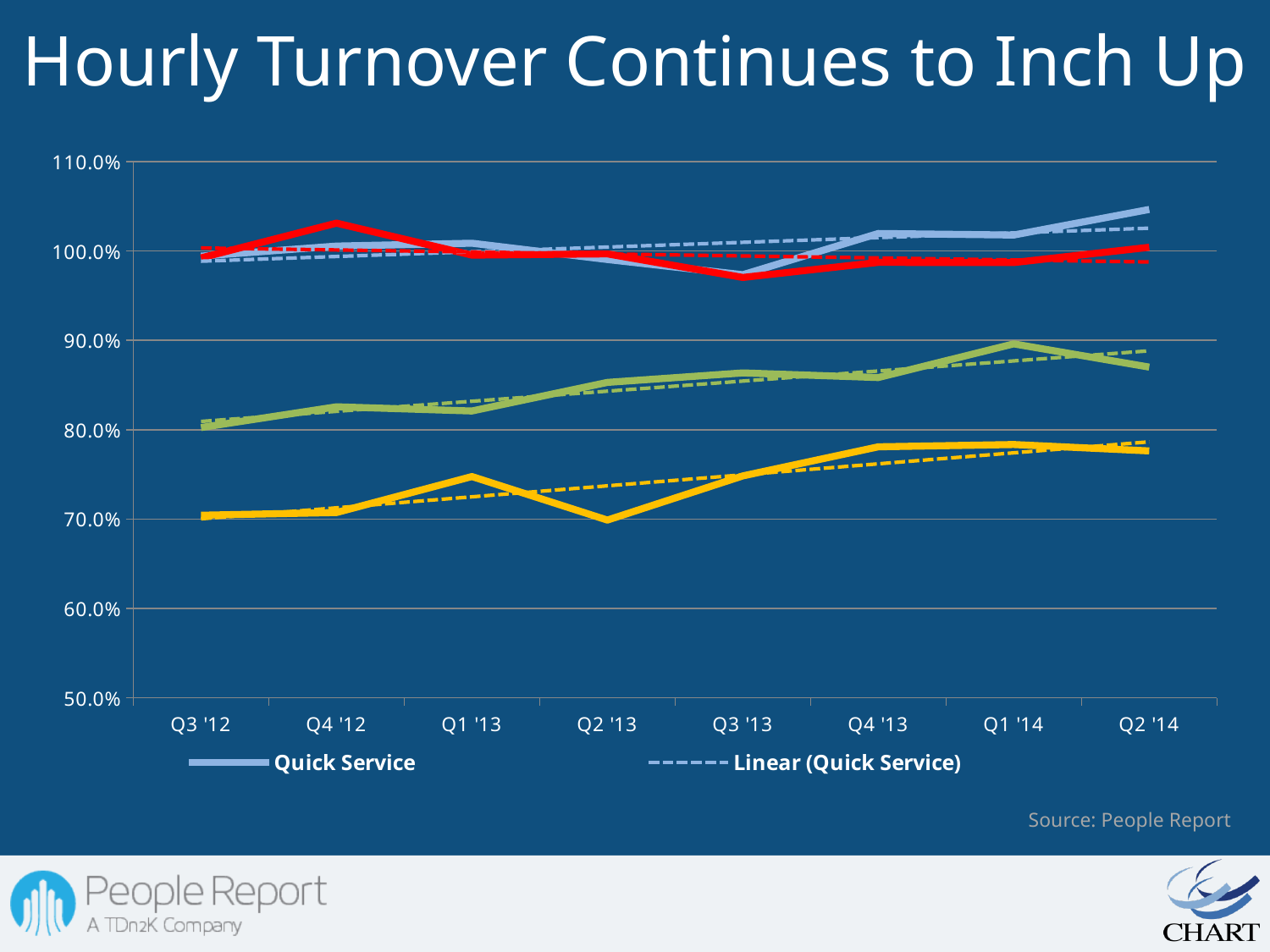
What kind of chart is shown on the slide? line chart Is the Quick Service value for Q3 '12 greater or less than 90.0%? greater Is the Quick Service value for Q3 '13 greater or less than 100.0%? less What label does the legend give to the dashed line? Linear (Quick Service) Which is larger for the Quick Service line, the value at Q4 '13 or the value at Q3 '13? Q4 '13 Is the Quick Service value for Q2 '14 greater or less than 100.0%? greater What is the title of the chart on the slide? Hourly Turnover Continues to Inch Up Which quarter has the highest value for the Quick Service line? Q2 '14 Does the Quick Service line generally rise or fall from Q3 '12 to Q2 '14? rise Which quarter has the lowest value for the Quick Service line? Q3 '13 How many quarters are shown along the x axis? 8 How many series does the legend list? 2